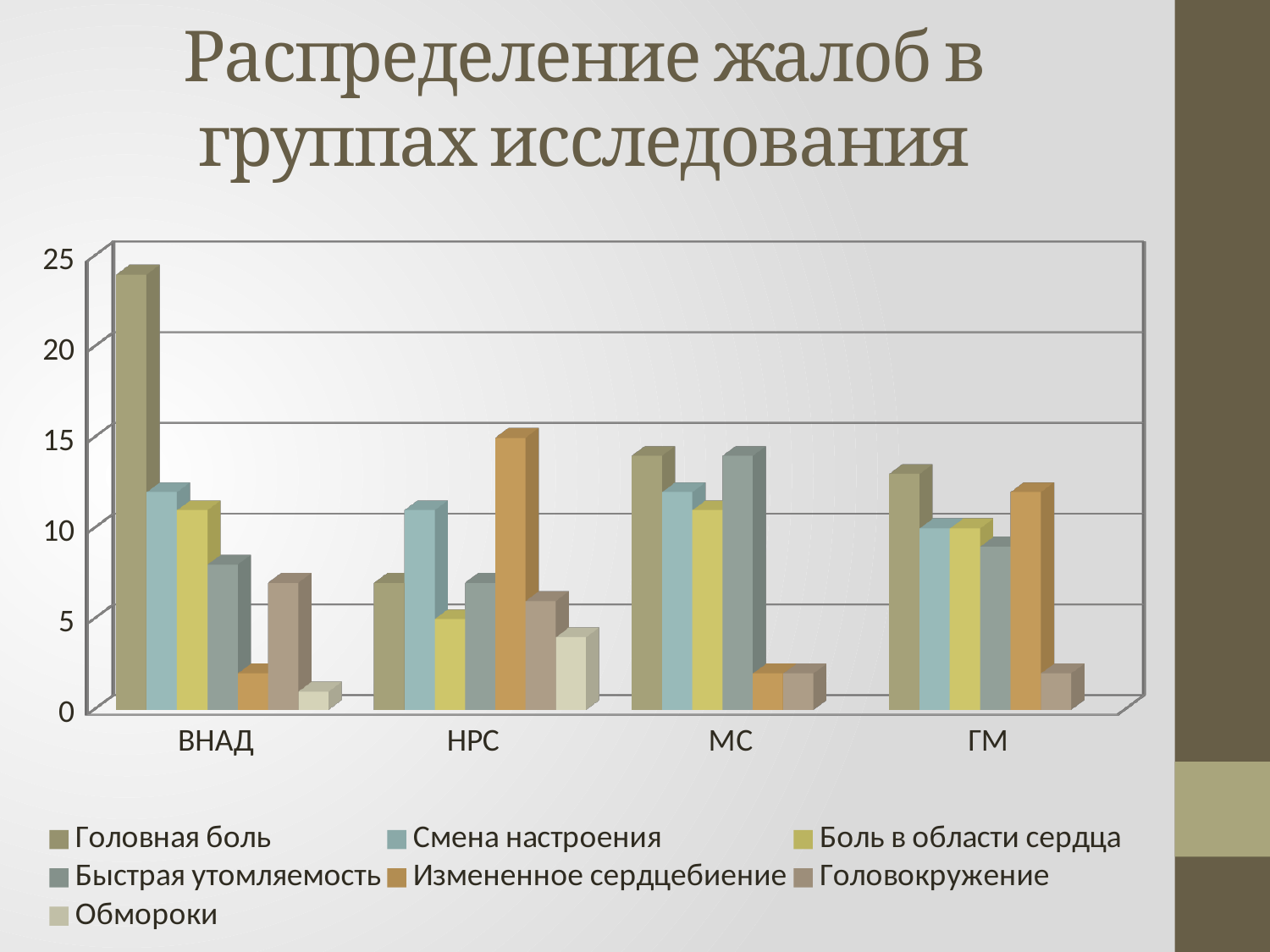
Is the value for Головная боль in the ВНАД group greater or less than 20? greater Which is larger: Головная боль in ВНАД or in МС? ВНАД In the НРС group, which complaint has the highest value? Измененное сердцебиение Is the value for Измененное сердцебиение in the НРС group greater or less than 10? greater Which group has the highest value for Головная боль? ВНАД How many series does the legend list? 7 Is the value for Головокружение in the МС group greater or less than 5? less Which is larger: Измененное сердцебиение in ВНАД or in НРС? НРС In the ВНАД group, which complaint has the lowest value? Обмороки What is the title of the chart? Распределение жалоб в группах исследования What kind of chart is shown on the slide? bar chart How many study groups are shown along the x axis? 4